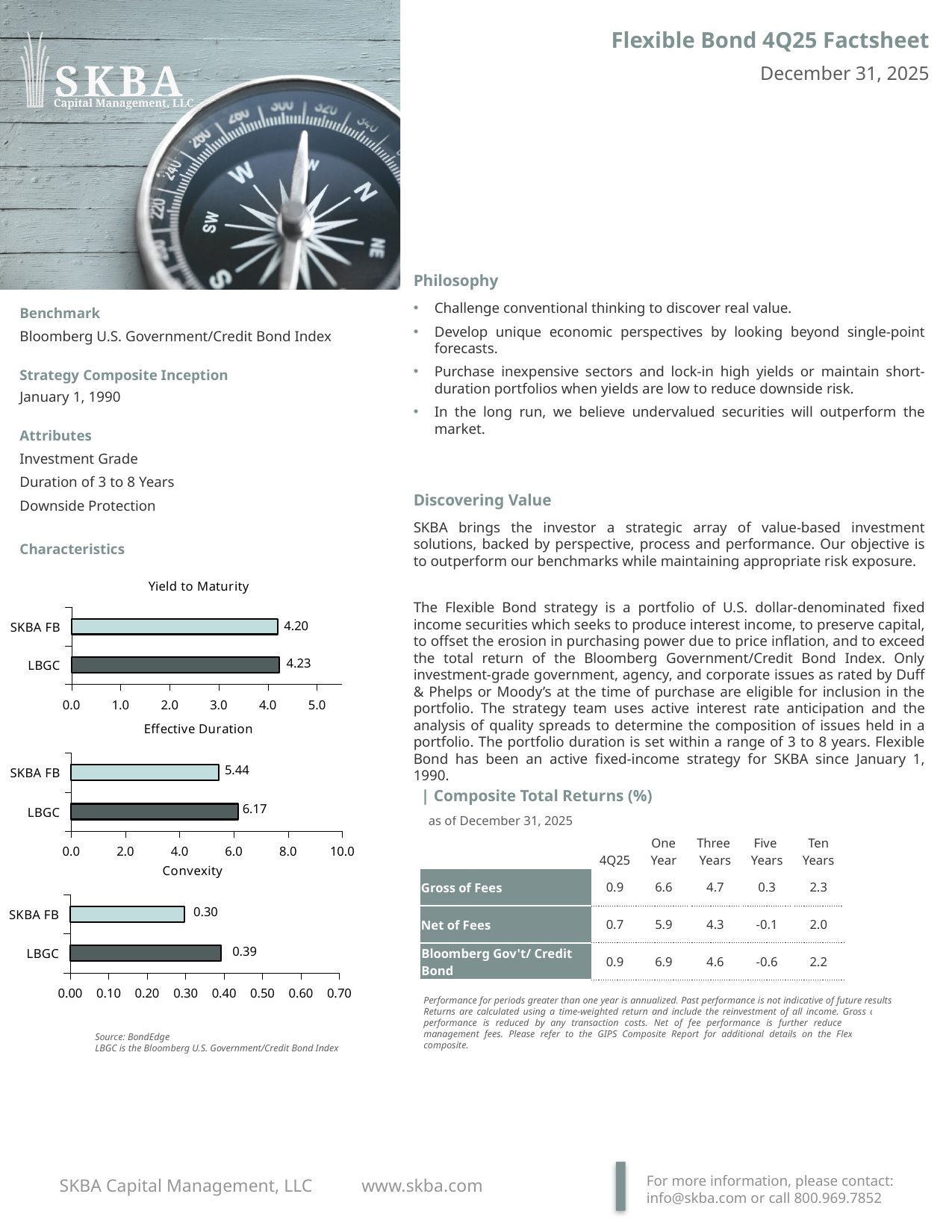
In the Convexity chart, what is the value for SKBA FB? 0.30 In the Effective Duration chart, what is the difference between the LBGC and SKBA FB values? 0.73 In the Yield to Maturity chart, what is the value for SKBA FB? 4.20 In the Yield to Maturity chart, what is the value for LBGC? 4.23 In the Convexity chart, what is the value for LBGC? 0.39 In the Effective Duration chart, what is the value for SKBA FB? 5.44 In the Convexity chart, what is the difference between the LBGC and SKBA FB values? 0.09 How many categories are shown in the Effective Duration chart? 2 In the Effective Duration chart, which category has the higher value? LBGC In the Effective Duration chart, what is the value for LBGC? 6.17 What kind of chart is the Yield to Maturity chart? Bar chart In the Convexity chart, which category has the lower value? SKBA FB